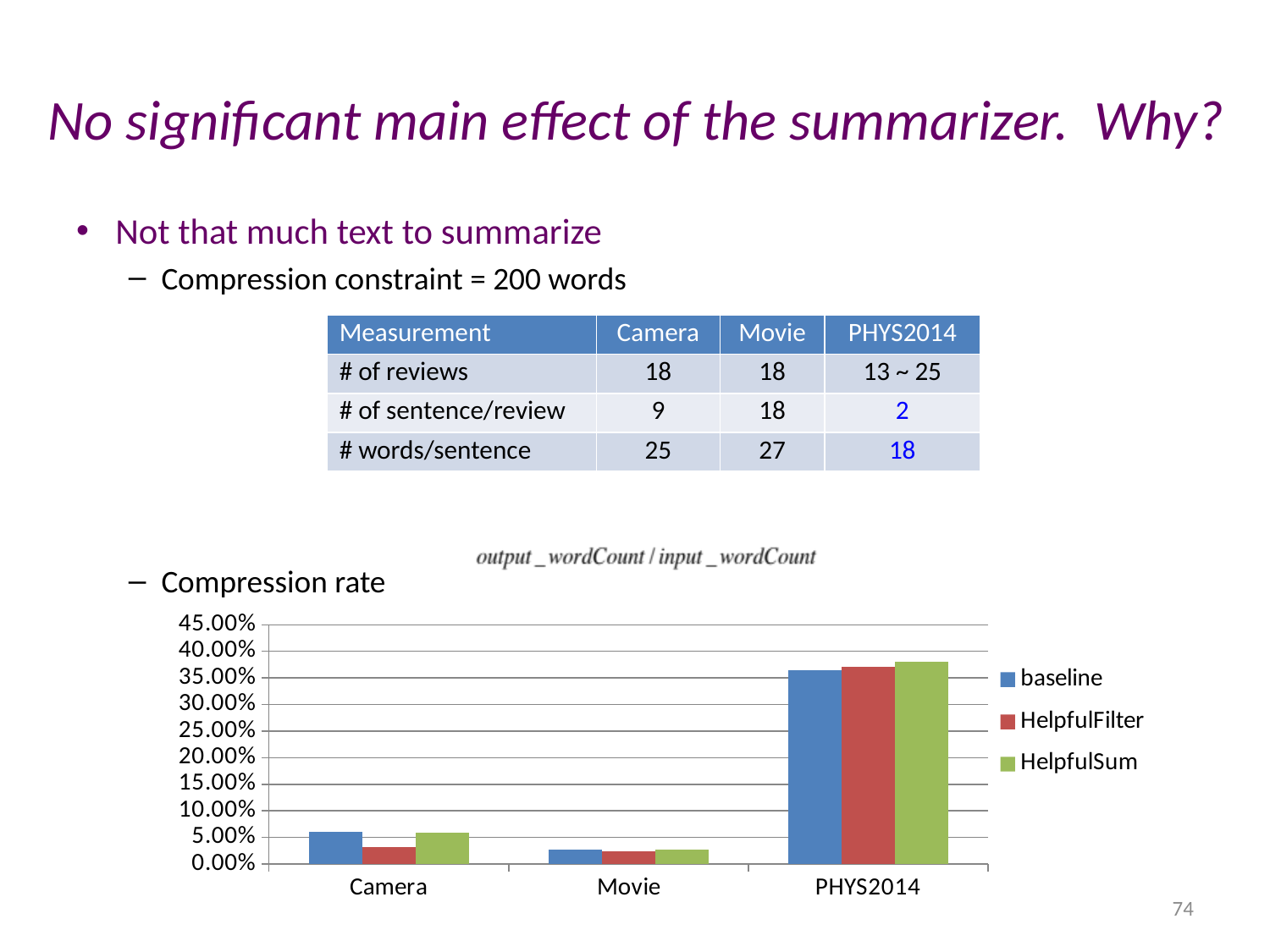
What kind of chart is shown on the slide? bar chart Is the HelpfulFilter value for Movie greater or less than 5.00%? less Is the baseline value for Camera greater or less than 10.00%? less Is the HelpfulSum value for PHYS2014 greater or less than 35.00%? greater How many categories are shown on the x axis of the chart? 3 How many series does the chart's legend list? 3 Which category has the highest compression rate values in the chart? PHYS2014 Which category has the lowest compression rate values in the chart? Movie Which is larger: the HelpfulSum value for PHYS2014 or the HelpfulSum value for Camera? PHYS2014 What colour represents the HelpfulSum series in the chart's legend? green For Camera, which is larger: the baseline value or the HelpfulFilter value? baseline